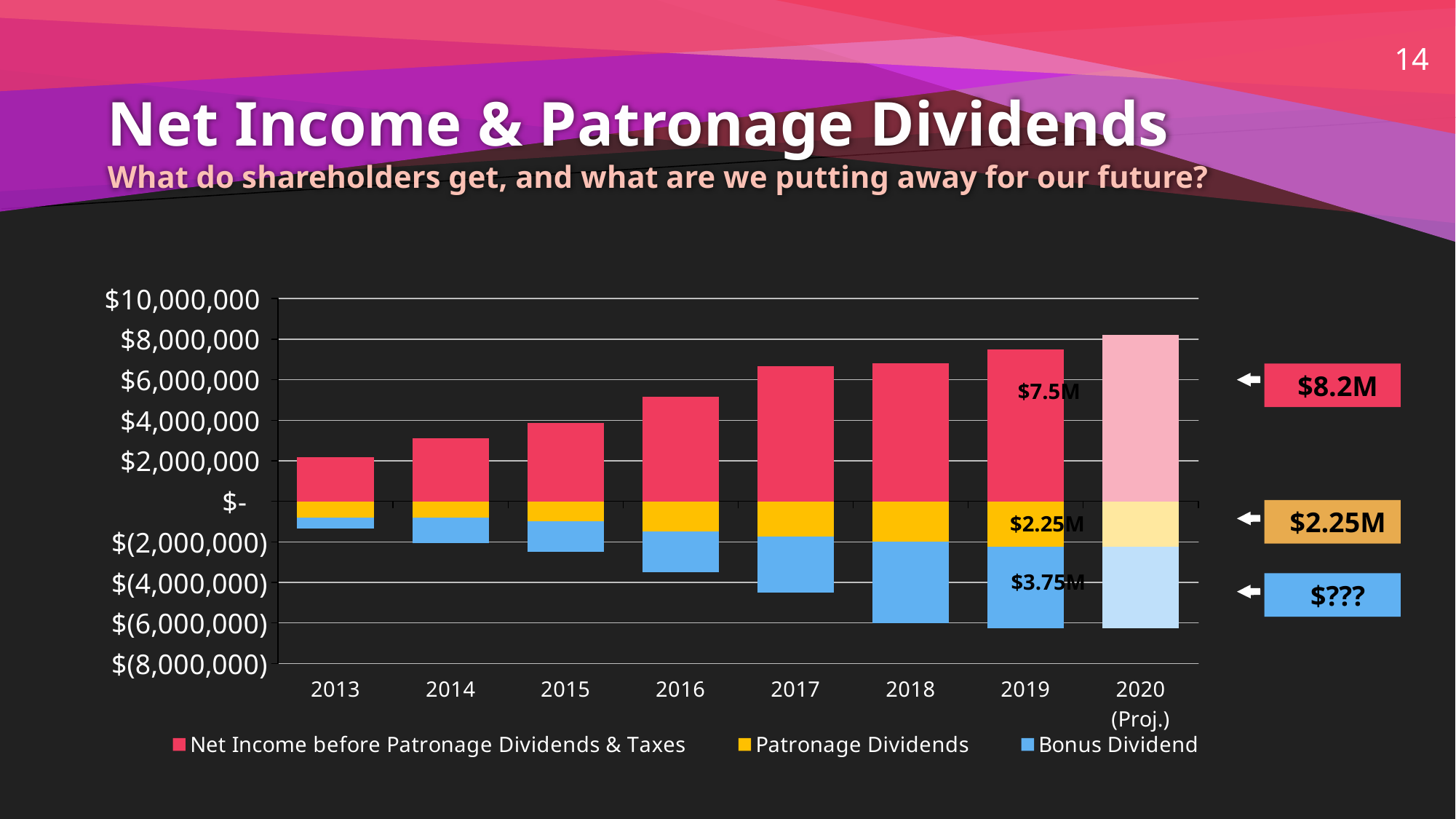
What kind of chart is shown on the slide? Stacked bar chart What is the difference between the 2020 projected Net Income ($8.2M) and the 2019 Net Income ($7.5M)? $0.7M Which year has the highest Net Income before Patronage Dividends & Taxes? 2020 (Proj.) Is the Net Income before Patronage Dividends & Taxes for 2013 greater or less than $4,000,000? less In 2019, which is larger: the Bonus Dividend or the Patronage Dividends? Bonus Dividend What is the Patronage Dividends value for 2019? $2.25M Which year has the lowest Net Income before Patronage Dividends & Taxes? 2013 What is the Net Income before Patronage Dividends & Taxes for 2019? $7.5M How many series does the legend list? 3 What is the projected Net Income before Patronage Dividends & Taxes for 2020? $8.2M How many years are shown on the x axis? 8 What is the Bonus Dividend value for 2019? $3.75M